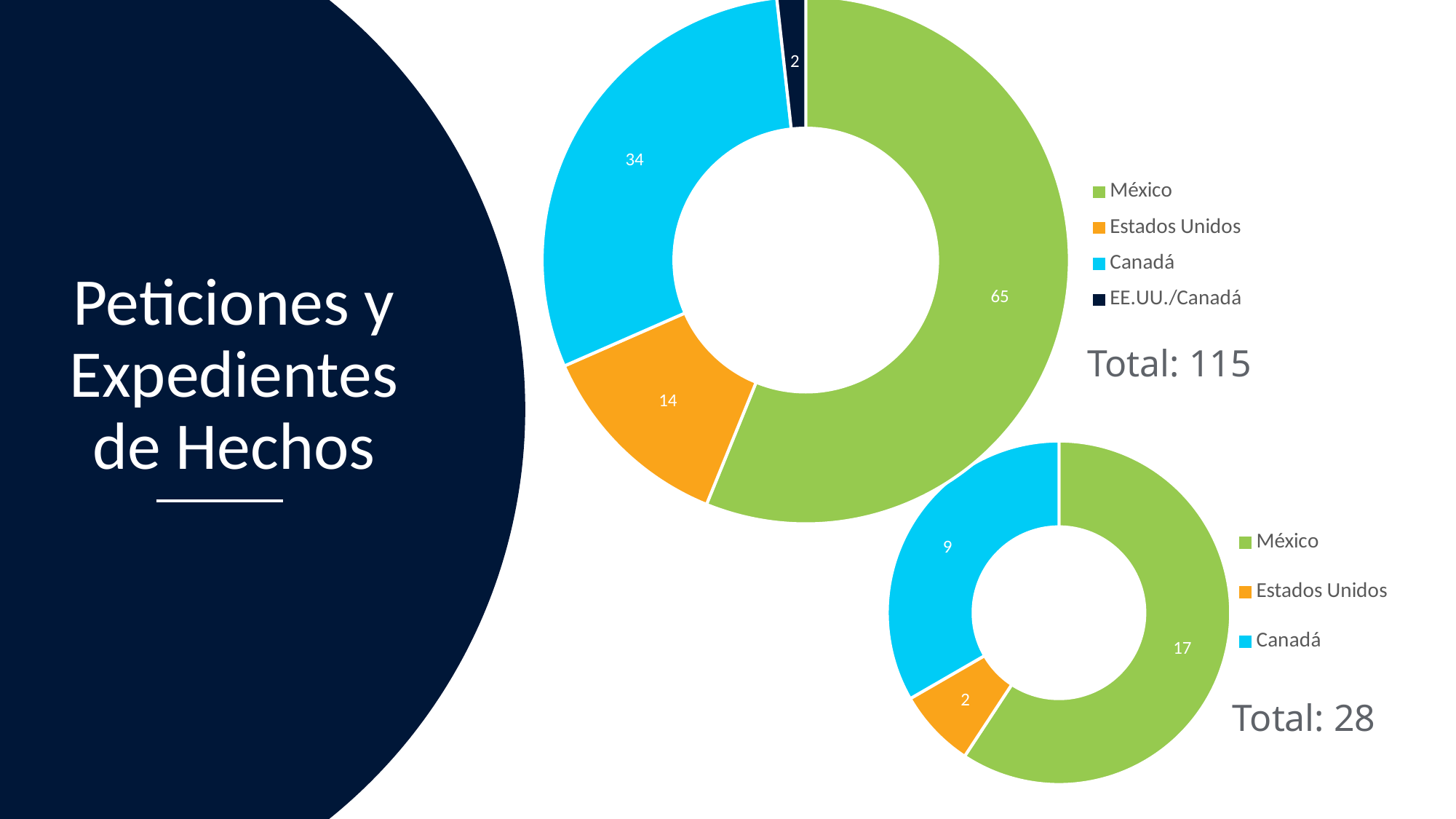
In the larger donut chart at the top of the slide, how many categories does the legend list? 4 In the larger donut chart at the top of the slide, which category has the smallest value? EE.UU./Canadá In the larger donut chart at the top of the slide, what is the value for Canadá? 34 In the smaller donut chart at the bottom right of the slide, what is the value for Canadá? 9 In the smaller donut chart at the bottom right of the slide, is the value for México larger or the value for Canadá? México What total is printed next to the larger donut chart at the top of the slide? Total: 115 In the larger donut chart at the top of the slide, what is the difference between the values for Canadá and Estados Unidos? 20 In the smaller donut chart at the bottom right of the slide, what is the difference between the values for México and Estados Unidos? 15 In the larger donut chart at the top of the slide, what is the value for EE.UU./Canadá? 2 In the larger donut chart at the top of the slide, what is the value for México? 65 In the smaller donut chart at the bottom right of the slide, which category has the largest value? México What kind of chart is the smaller chart at the bottom right of the slide? Donut (pie) chart